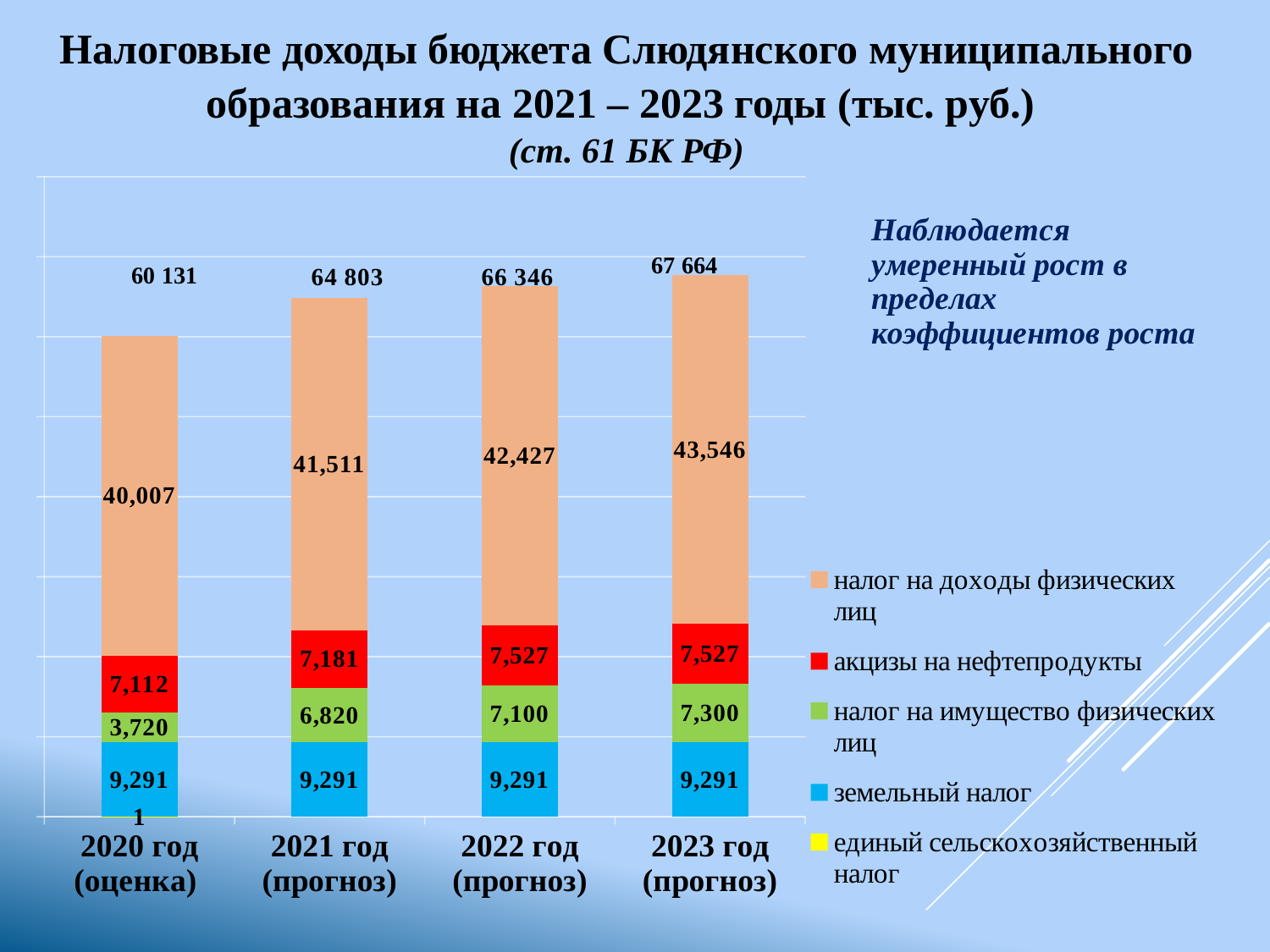
Which year has the highest total tax revenue? 2023 год (прогноз) What is the total of the stacked bar for 2021 год (прогноз)? 64 803 What is the value of налог на имущество физических лиц for 2020 год (оценка)? 3,720 How many series does the legend list? 5 Which year has the lowest value for налог на имущество физических лиц? 2020 год (оценка) What is the value of акцизы на нефтепродукты for 2021 год (прогноз)? 7,181 What is the value of земельный налог for 2023 год (прогноз)? 9,291 What is the difference between акцизы на нефтепродукты in 2022 год (прогноз) and 2021 год (прогноз)? 346 What is the value of налог на доходы физических лиц for 2022 год (прогноз)? 42,427 Which is larger: налог на имущество физических лиц in 2022 год (прогноз) or in 2021 год (прогноз)? 2022 год (прогноз) Does налог на доходы физических лиц rise or fall from 2020 to 2023? rise How many years (categories) are shown on the x axis? 4